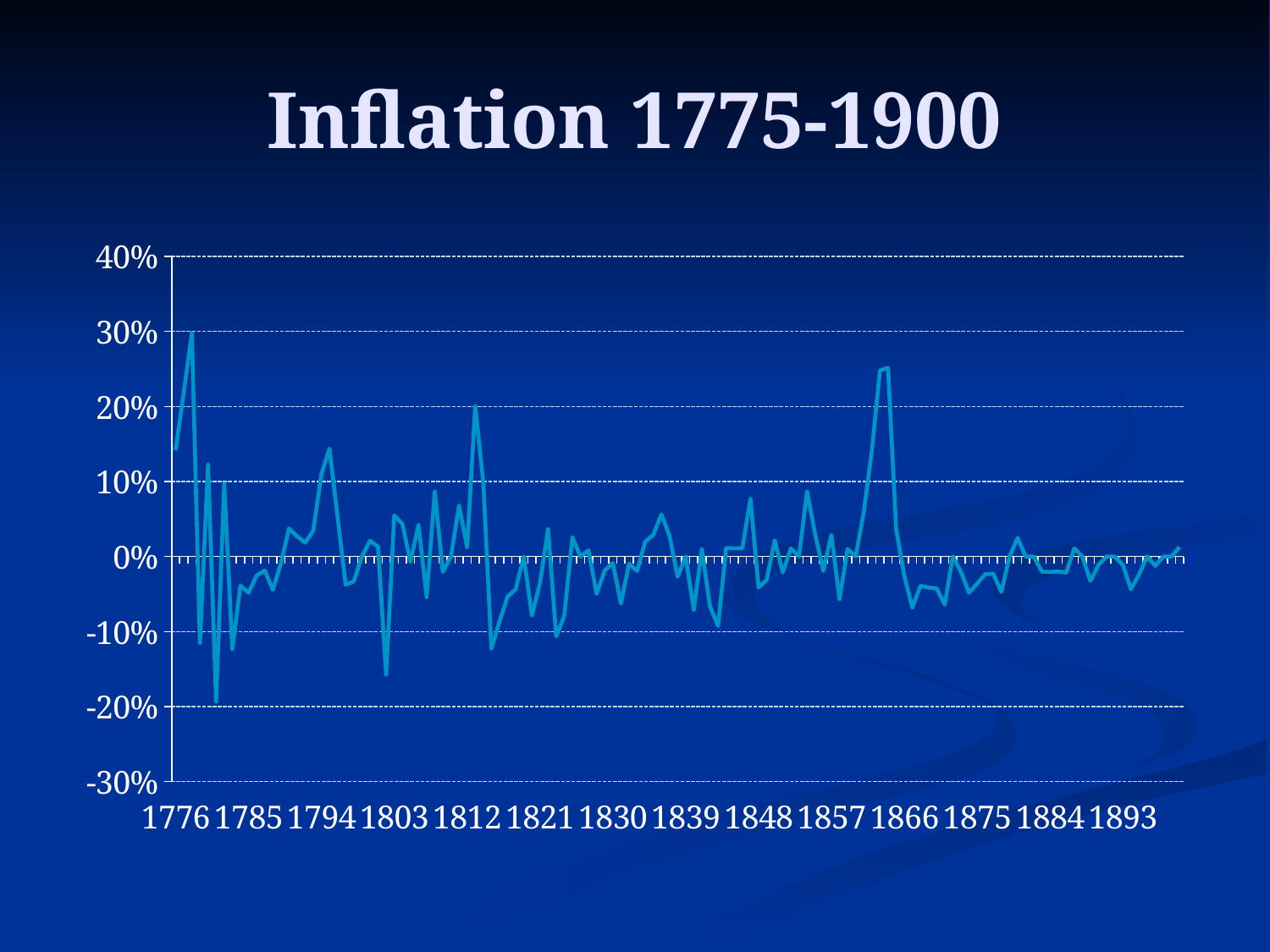
Which is larger: the peak of the inflation line shortly after 1776 or the peak between 1857 and 1866? the peak shortly after 1776 Is the highest peak of the inflation line greater or less than 20%? greater Is the value of the inflation line at the first x-axis label, 1776, greater or less than 10%? greater Is the peak of the inflation line that occurs between 1857 and 1866 greater or less than 20%? greater What kind of chart is shown on the slide? line chart What is the title of the chart? Inflation 1775-1900 What is the first year label on the x axis of the chart? 1776 What is the highest value shown on the y axis of the chart? 40% How many year labels are shown along the x axis of the chart? 14